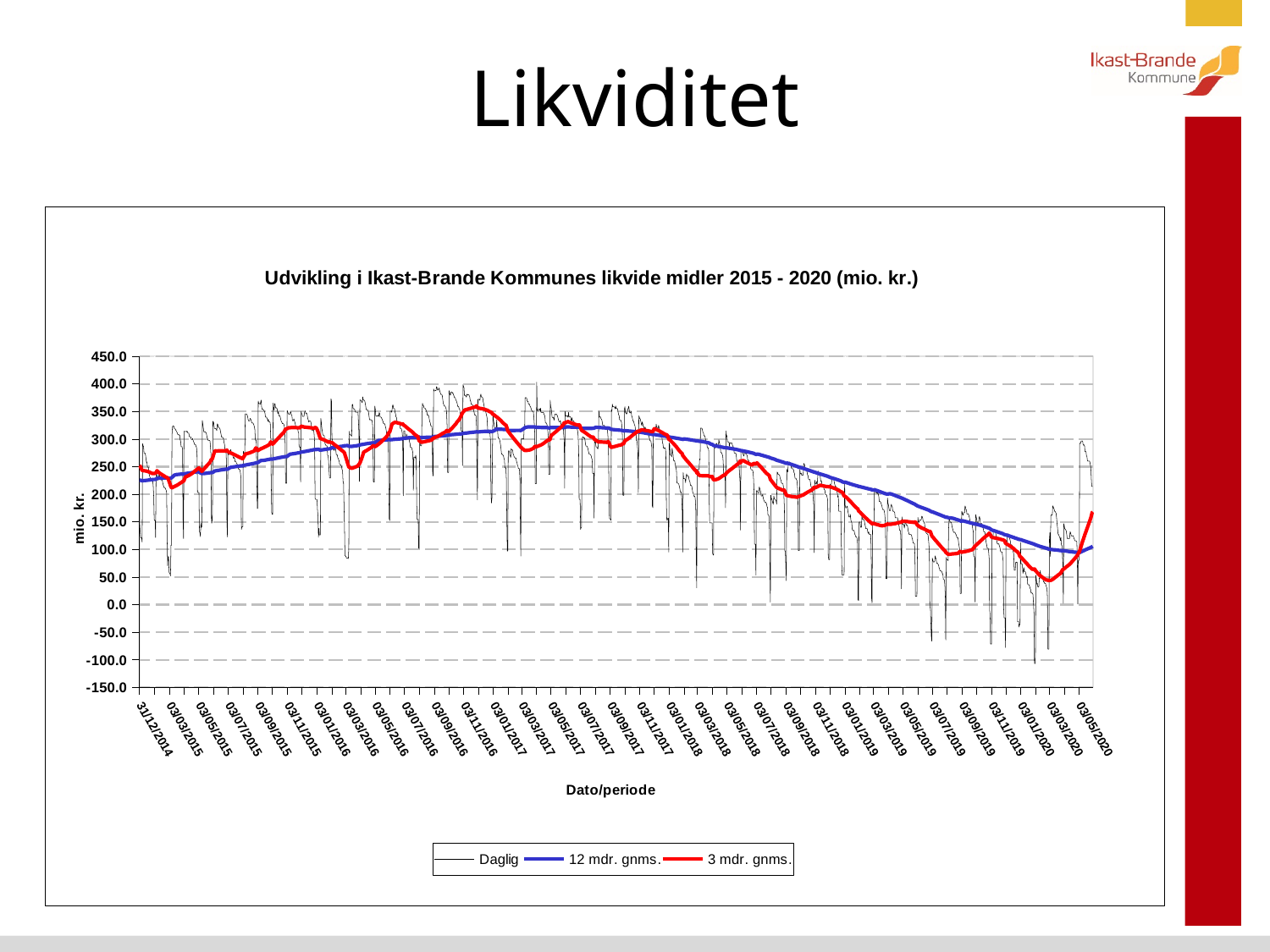
At 03/01/2020, which is higher: the 12 mdr. gnms. line or the 3 mdr. gnms. line? 12 mdr. gnms. At 03/05/2020, which is higher: the 3 mdr. gnms. line or the 12 mdr. gnms. line? 3 mdr. gnms. Does the 3 mdr. gnms. line rise or fall between 03/03/2020 and 03/05/2020? rise Is the 3 mdr. gnms. value at 03/11/2016 greater or less than 300.0? greater What is the title of the chart? Udvikling i Ikast-Brande Kommunes likvide midler 2015 - 2020 (mio. kr.) Is the 12 mdr. gnms. value at 03/01/2016 greater or less than 300.0? less How many series does the legend list? 3 What kind of chart is shown on the slide? line chart Is the 3 mdr. gnms. value at 03/01/2020 greater or less than 100.0? less Does the 12 mdr. gnms. line rise or fall between 03/01/2018 and 03/05/2020? fall Which series is drawn in red according to the legend? 3 mdr. gnms.